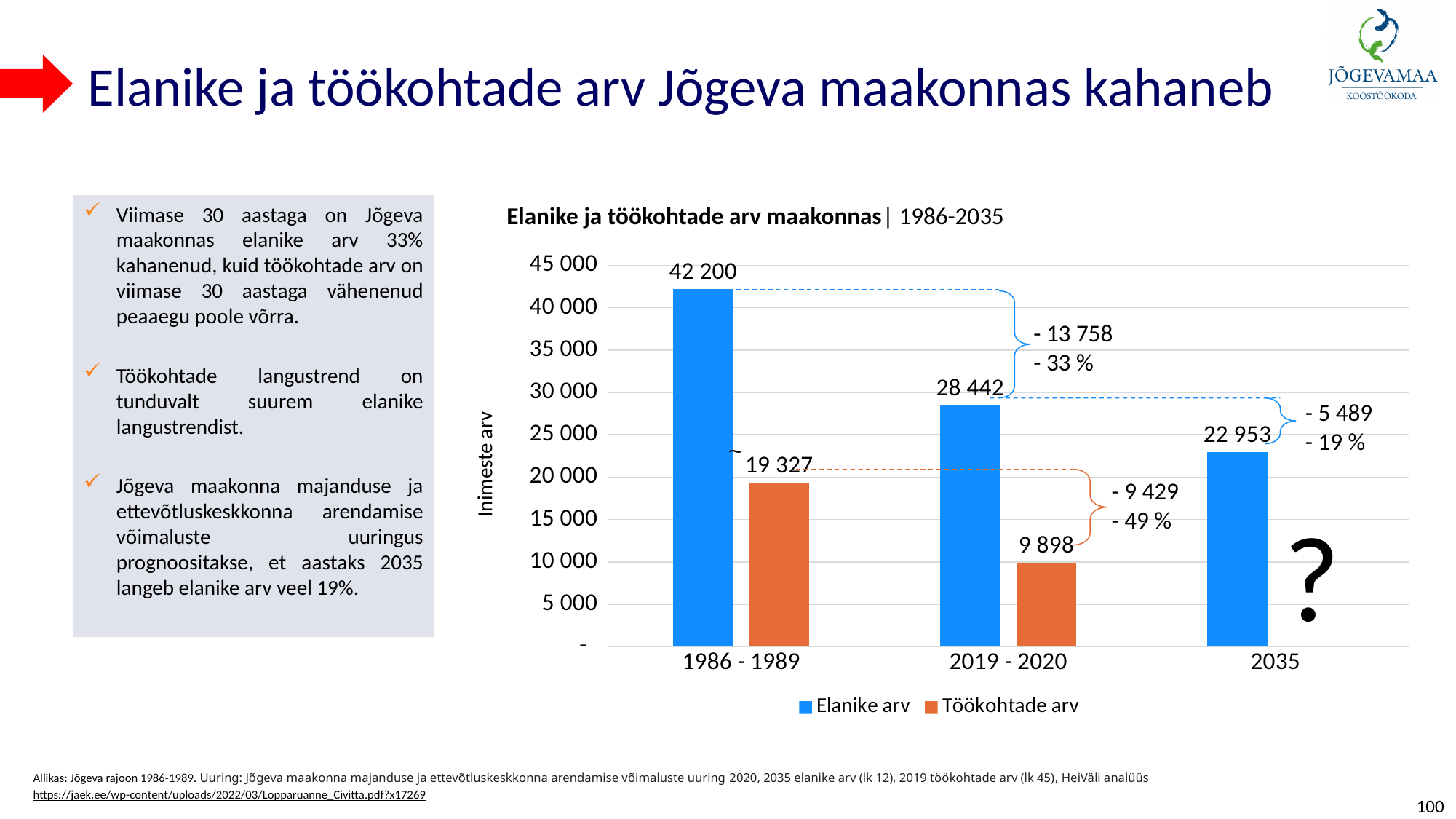
Is the value of Töökohtade arv for 1986 - 1989 greater or less than 20 000? less What is the value of Elanike arv for 1986 - 1989? 42 200 How many series does the legend list? 2 Which is larger in 2019 - 2020: Elanike arv or Töökohtade arv? Elanike arv What is the difference between Elanike arv in 1986 - 1989 and in 2019 - 2020? 13 758 What is the value of Elanike arv for 2019 - 2020? 28 442 What is the value of Töökohtade arv for 2019 - 2020? 9 898 Which period has the highest value of Elanike arv? 1986 - 1989 Which period has the lowest value of Elanike arv? 2035 What is the difference between Elanike arv in 2019 - 2020 and in 2035? 5 489 What is the projected value of Elanike arv for 2035? 22 953 What kind of chart is shown on the slide? Bar chart